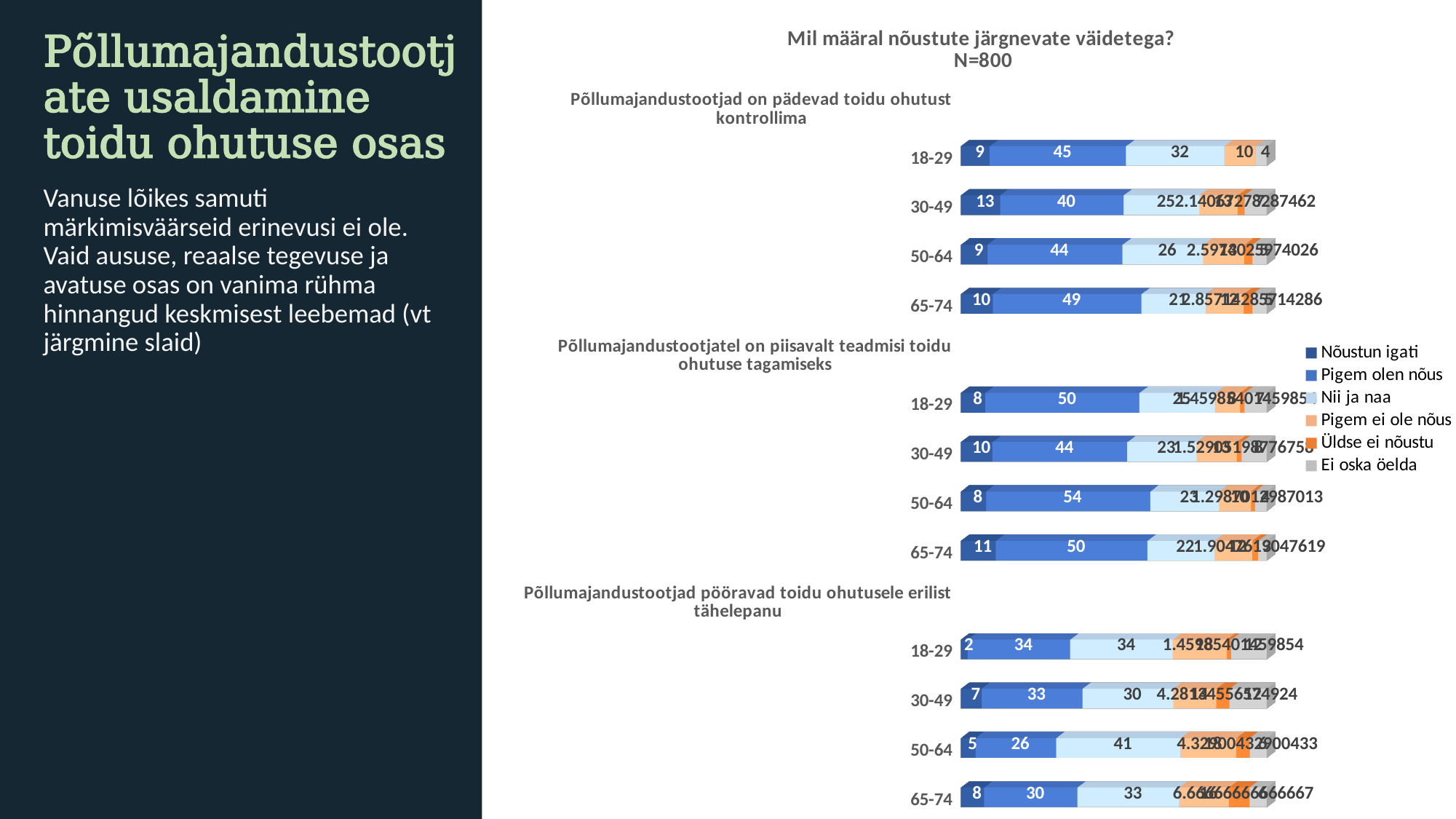
For the statement 'Põllumajandustootjatel on piisavalt teadmisi toidu ohutuse tagamiseks', which age group has the highest 'Pigem olen nõus' value? 50-64 How many age groups are shown under each statement? 4 How many series does the legend list? 6 For the statement 'Põllumajandustootjad on pädevad toidu ohutust kontrollima', what is the difference between the 'Pigem olen nõus' and 'Nii ja naa' values for the 18-29 age group? 13 For the statement 'Põllumajandustootjad pööravad toidu ohutusele erilist tähelepanu', which age group has the lowest 'Nõustun igati' value? 18-29 For the statement 'Põllumajandustootjatel on piisavalt teadmisi toidu ohutuse tagamiseks', what is the 'Pigem olen nõus' value for the 50-64 age group? 54 What sample size (N) is stated in the chart title? N=800 For the statement 'Põllumajandustootjad pööravad toidu ohutusele erilist tähelepanu', which is larger for the 50-64 age group: 'Pigem olen nõus' or 'Nii ja naa'? Nii ja naa For the statement 'Põllumajandustootjad on pädevad toidu ohutust kontrollima', what is the 'Pigem olen nõus' value for the 18-29 age group? 45 What kind of chart is shown on the slide? bar chart For the statement 'Põllumajandustootjad on pädevad toidu ohutust kontrollima', what is the 'Nõustun igati' value for the 30-49 age group? 13 For the statement 'Põllumajandustootjad pööravad toidu ohutusele erilist tähelepanu', what is the 'Nii ja naa' value for the 50-64 age group? 41